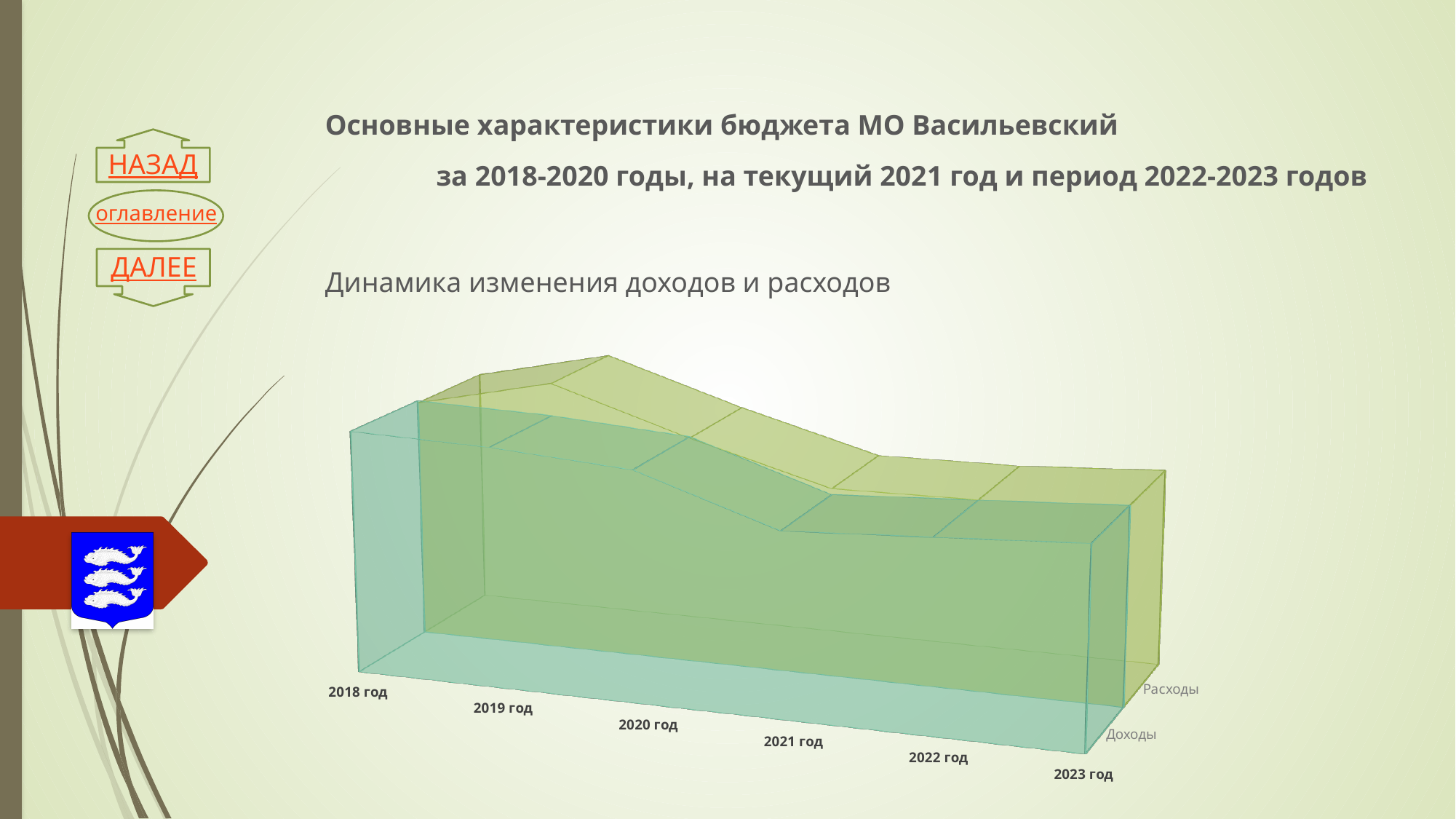
How many years are shown along the x axis of the chart? 6 How many series does the chart's legend list? 2 What is the title of the chart? Динамика изменения доходов и расходов What are the two series named in the chart's legend? Расходы and Доходы What kind of chart is shown on the slide? area chart Do the values for Доходы rise or fall from 2019 год to 2021 год? fall Which is the last year shown on the x axis? 2023 год Do the values for Расходы rise or fall from 2018 год to 2019 год? rise Do the values for Расходы rise or fall from 2019 год to 2021 год? fall Which is the first year shown on the x axis? 2018 год Which year has the highest value for Расходы? 2019 год